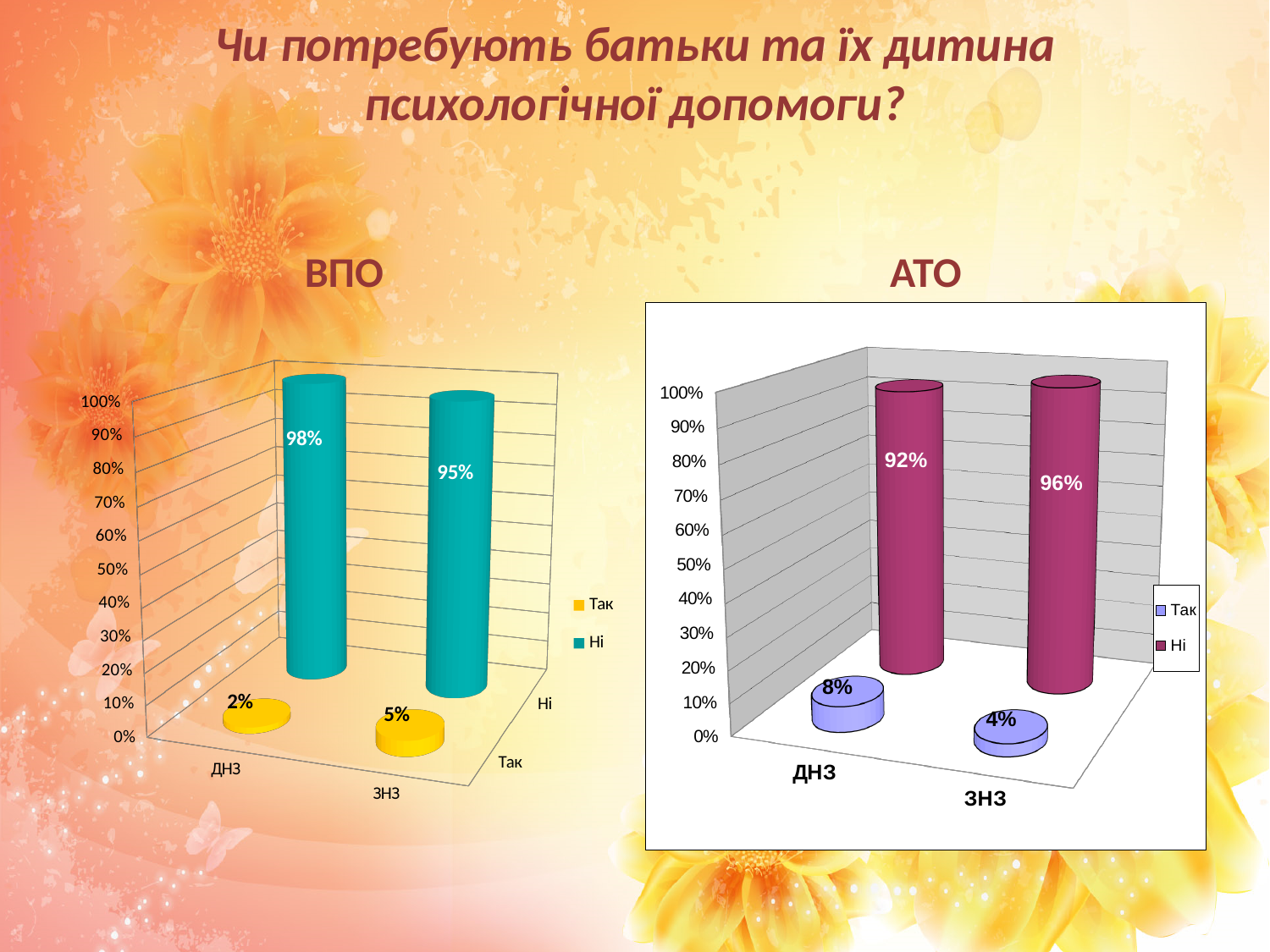
What type of chart is the АТО chart? bar chart In the ВПО chart, what is the difference between Ні and Так for ДНЗ? 96% In the АТО chart, what is the difference between the Ні values for ЗНЗ and ДНЗ? 4% In the ВПО chart, is the value of Ні for ЗНЗ greater or less than 90%? greater In the АТО chart, which category has the higher Так value, ДНЗ or ЗНЗ? ДНЗ In the ВПО chart, what is the value of Так for ЗНЗ? 5% In the АТО chart, what is the value of Ні for ЗНЗ? 96% How many categories are shown on the x axis of the ВПО chart? 2 How many series does the legend of the АТО chart list? 2 In the ВПО chart, what is the value of Ні for ДНЗ? 98% In the АТО chart, what is the value of Так for ДНЗ? 8% In the ВПО chart, which category has the lowest Так value? ДНЗ